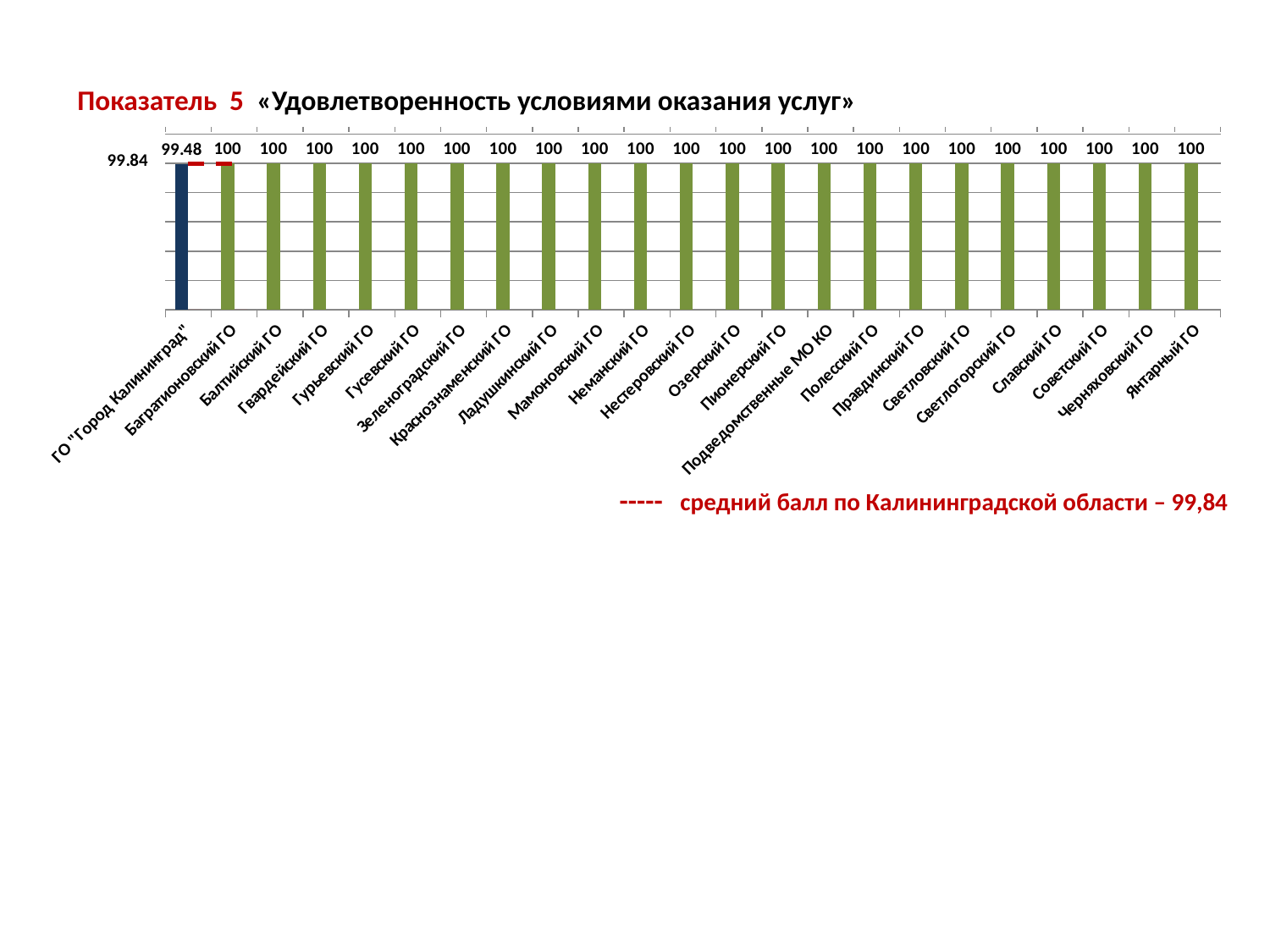
Which is larger, the value for ГО "Город Калининград" or the value for Советский ГО? Советский ГО What is the average score for the Kaliningrad region shown by the dashed line? 99,84 What kind of chart is shown on the slide? Bar chart How many categories have a value of 100? 22 How many categories are shown on the x axis? 23 Which category has the lowest value? ГО "Город Калининград" What is the difference between the value for Балтийский ГО and the value for ГО "Город Калининград"? 0.52 What is the value for ГО "Город Калининград"? 99.48 What is the value for Багратионовский ГО? 100 What is the value for Янтарный ГО? 100 What is the value for Подведомственные МО КО? 100 What is the title of the indicator shown in the chart? Показатель 5 «Удовлетворенность условиями оказания услуг»